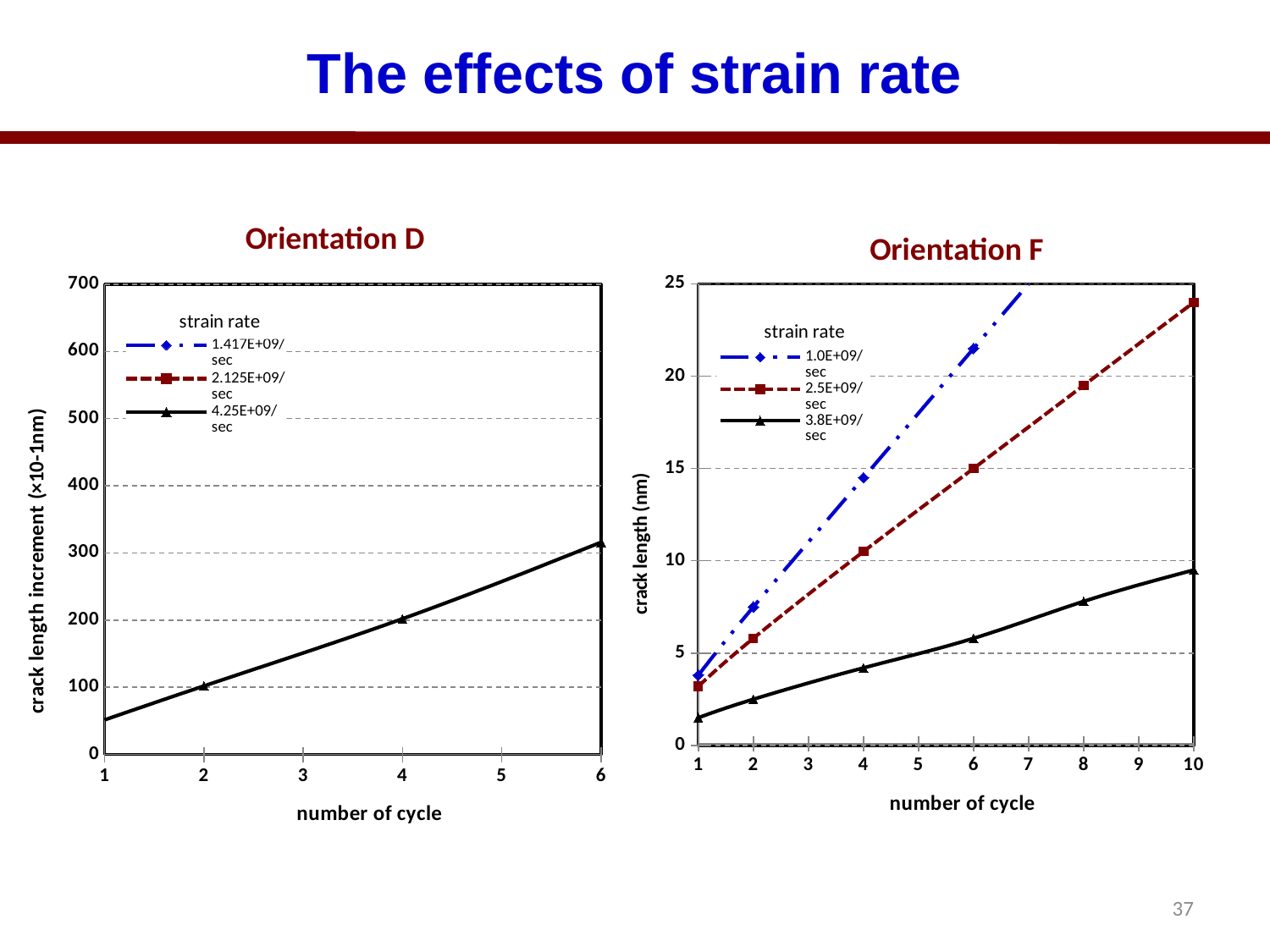
In the Orientation F chart, at cycle 10, which series has the larger crack length: 2.5E+09/sec or 3.8E+09/sec? 2.5E+09/sec In the Orientation F chart, is the crack length for the 3.8E+09/sec series at cycle 10 greater or less than 10? less In the Orientation F chart, does the crack length for the 3.8E+09/sec series rise or fall with the number of cycles? rises In the Orientation D chart, does the crack length increment rise or fall as the number of cycles increases? rises What kind of chart is the Orientation D chart? line chart In the Orientation F chart, is the crack length for the 2.5E+09/sec series at cycle 8 greater or less than 15? greater How many series does the legend of the Orientation F chart list? 3 What is the y-axis title of the Orientation F chart? crack length (nm) In the Orientation D chart, is the value for the 4.25E+09/sec series at cycle 6 greater or less than 250? greater How many series does the legend of the Orientation D chart list? 3 In the Orientation F chart, how many data points are plotted for the 3.8E+09/sec series? 6 In the Orientation F chart, which strain rate series has the highest crack length at cycle 6? 1.0E+09/sec